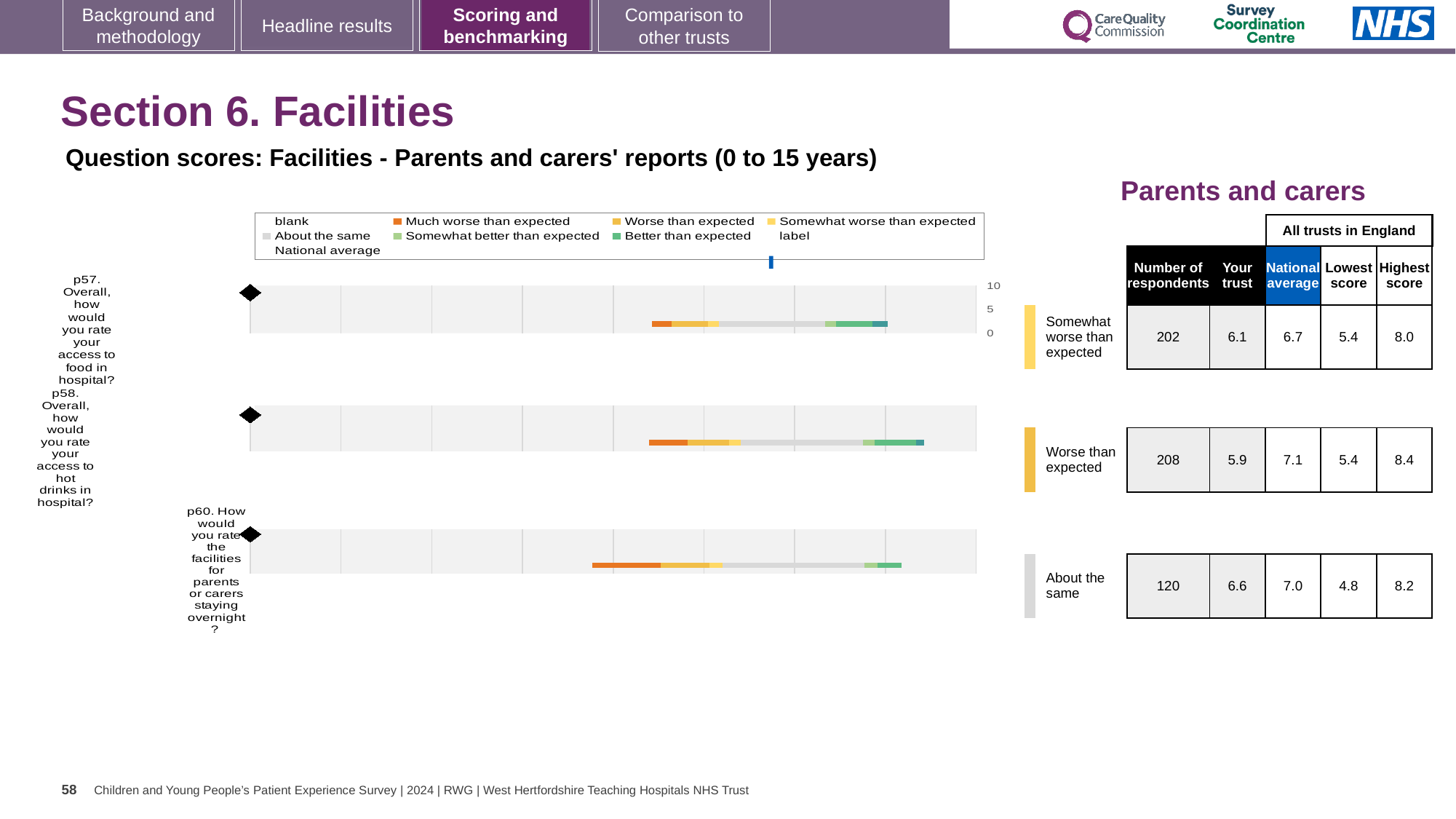
What colour does the legend use for 'Much worse than expected'? orange In the table beside the chart, what is the national average for p60 (facilities for parents or carers staying overnight)? 7.0 What kind of chart is shown on the slide? bar chart What is the heading above the chart? Question scores: Facilities - Parents and carers' reports (0 to 15 years) Which of the three questions has the highest 'Your trust' score in the table? p60 What is the difference between the national average and the 'Your trust' score for p57? 0.6 How many questions (categories) are plotted in the chart? 3 In the table beside the chart, what is the 'Your trust' score for p58 (access to hot drinks in hospital)? 5.9 In the table beside the chart, what is the number of respondents for p57 (access to food in hospital)? 202 How many entries does the chart legend list? 9 In the table beside the chart, what is the highest score for p58? 8.4 Which has the larger 'Your trust' score, p57 or p58? p57